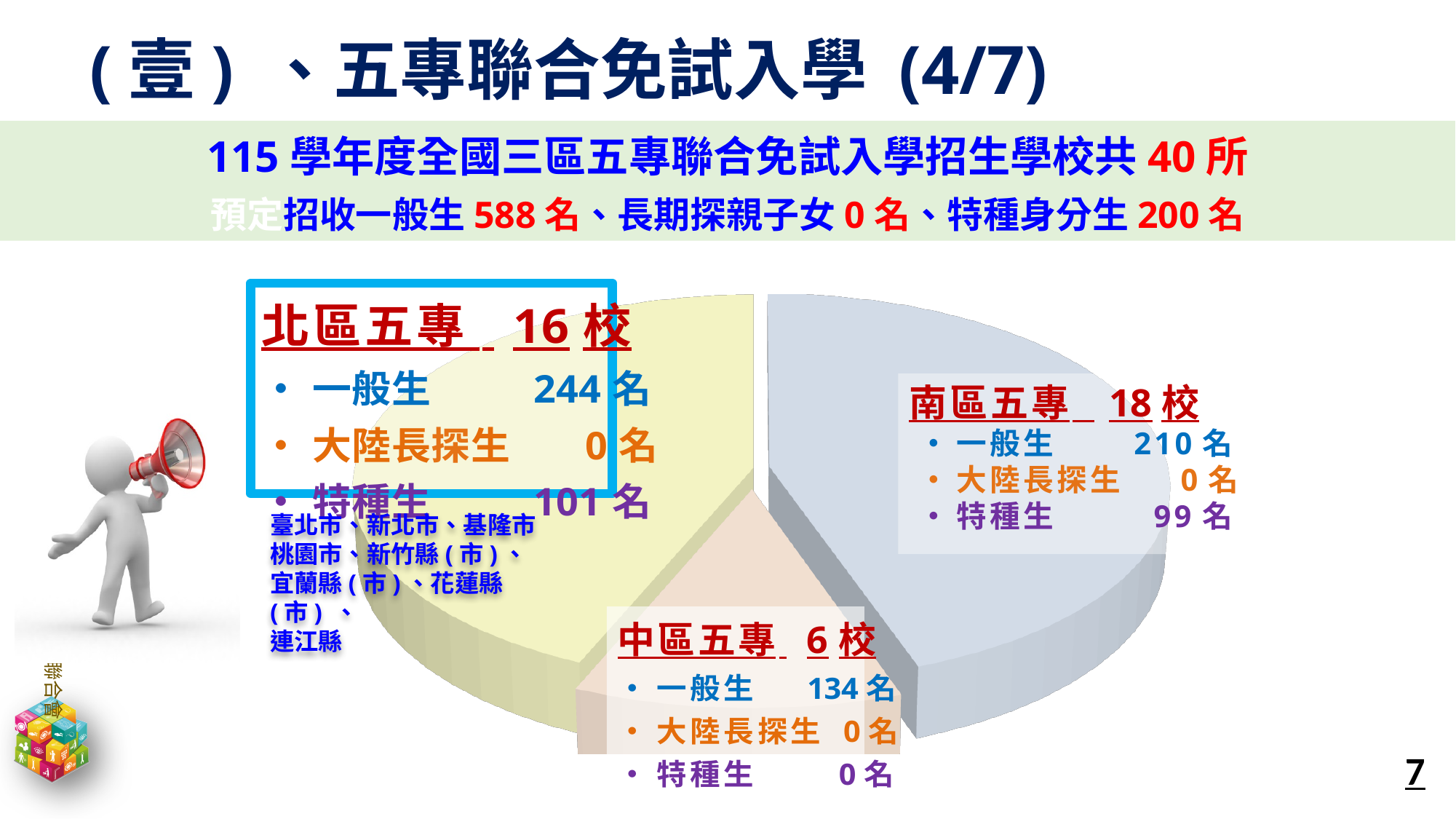
How many 一般生 does 北區五專 plan to admit? 244 名 How many 特種生 does 南區五專 plan to admit? 99 名 How many regions (slices) does the pie chart show? 3 What kind of chart is shown on the slide? pie chart How many schools are in 南區五專? 18 校 What is the difference in 一般生 between 北區五專 and 中區五專? 110 名 What is the total number of 一般生 across the three regions? 588 名 How many schools are in 中區五專? 6 校 Which region has the most schools? 南區五專 Which region has the fewest schools? 中區五專 Which region admits more 特種生, 北區五專 or 南區五專? 北區五專 How many schools are in 北區五專? 16 校